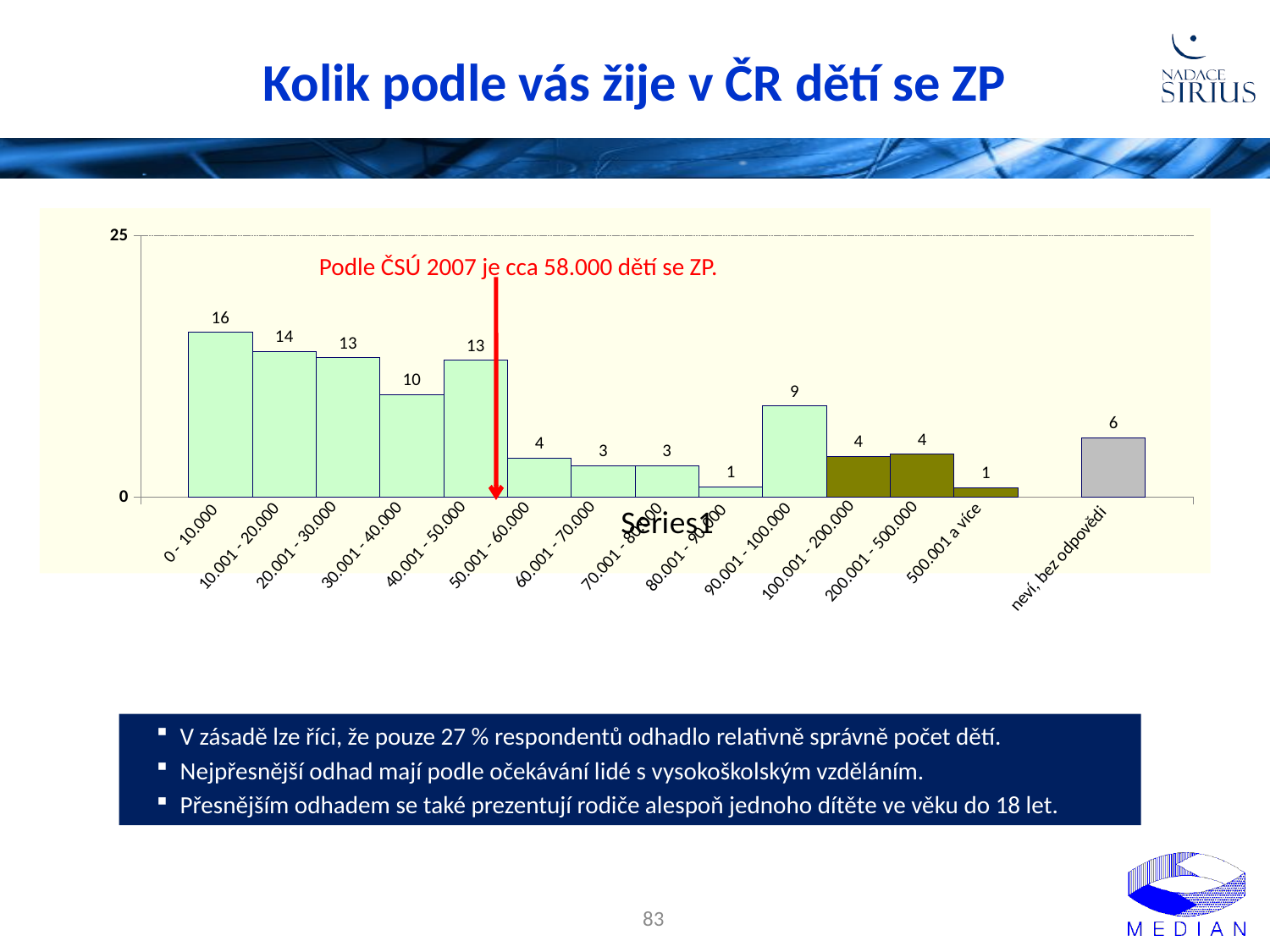
What is the difference between the values for 0 - 10.000 and 10.001 - 20.000? 2 Do the values rise or fall from 0 - 10.000 to 30.001 - 40.000? Fall What is the difference between the values for 40.001 - 50.000 and 50.001 - 60.000? 9 What value is shown for the category neví, bez odpovědi? 6 Which is larger, the value for 90.001 - 100.000 or the value for 100.001 - 200.000? 90.001 - 100.000 What value is shown for the category 30.001 - 40.000? 10 What value is shown for the category 90.001 - 100.000? 9 What does the red annotation text on the chart say? Podle ČSÚ 2007 je cca 58.000 dětí se ZP. How many categories are shown on the x axis? 14 Which category has the highest value? 0 - 10.000 What value is shown for the category 0 - 10.000? 16 What kind of chart is shown on the slide? Bar chart